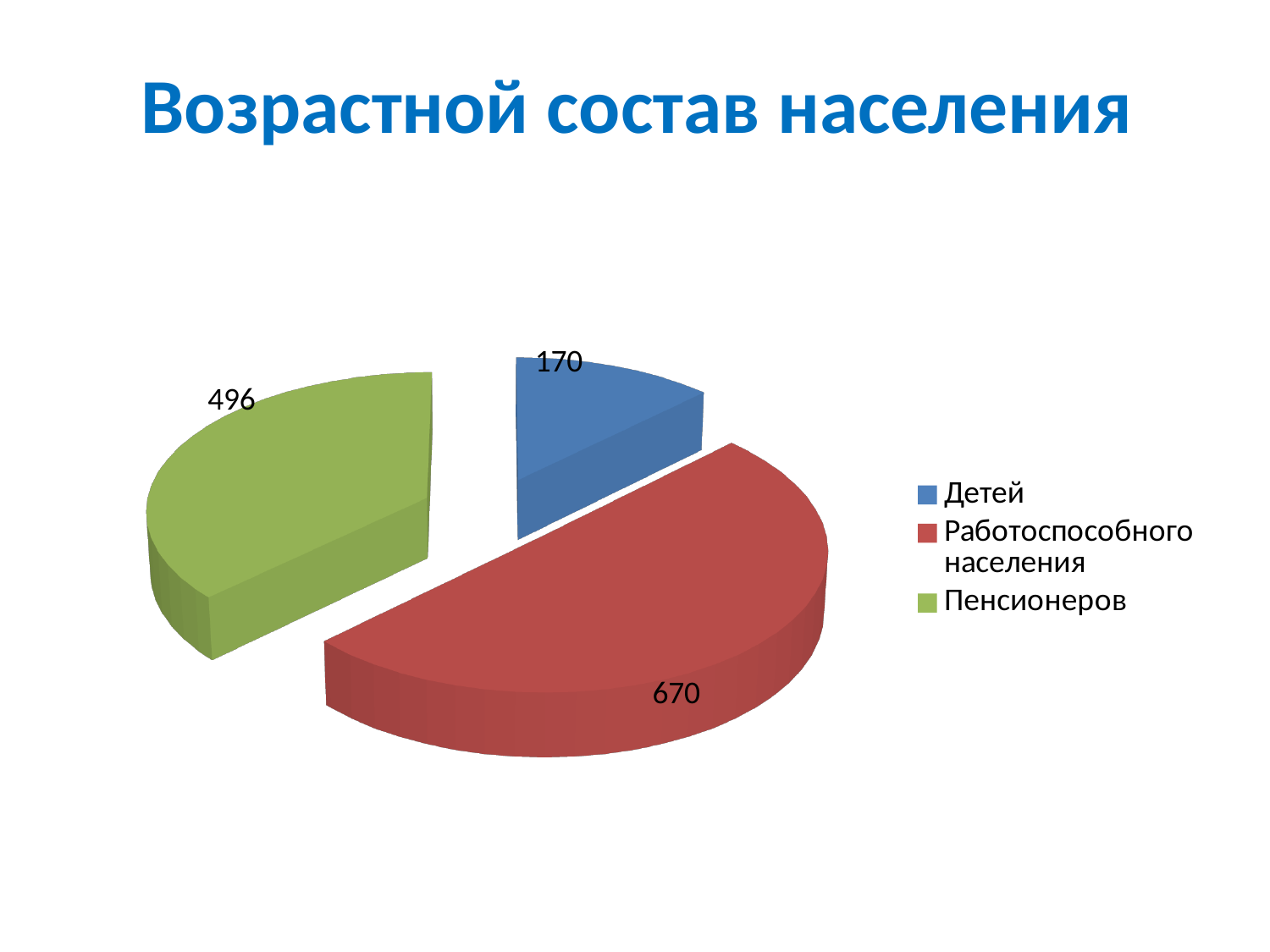
How many categories does the pie chart show? 3 What is the difference between the values for Работоспособного населения and Пенсионеров? 174 Which category has the largest slice? Работоспособного населения What is the difference between the values for Пенсионеров and Детей? 326 Which category has the smallest slice? Детей What kind of chart is shown on the slide? Pie chart What is the value for Пенсионеров? 496 What is the value for Детей? 170 What is the total of all slices in the pie chart? 1336 What is the value for Работоспособного населения? 670 What is the title of the chart? Возрастной состав населения Which is larger, the value for Пенсионеров or the value for Детей? Пенсионеров